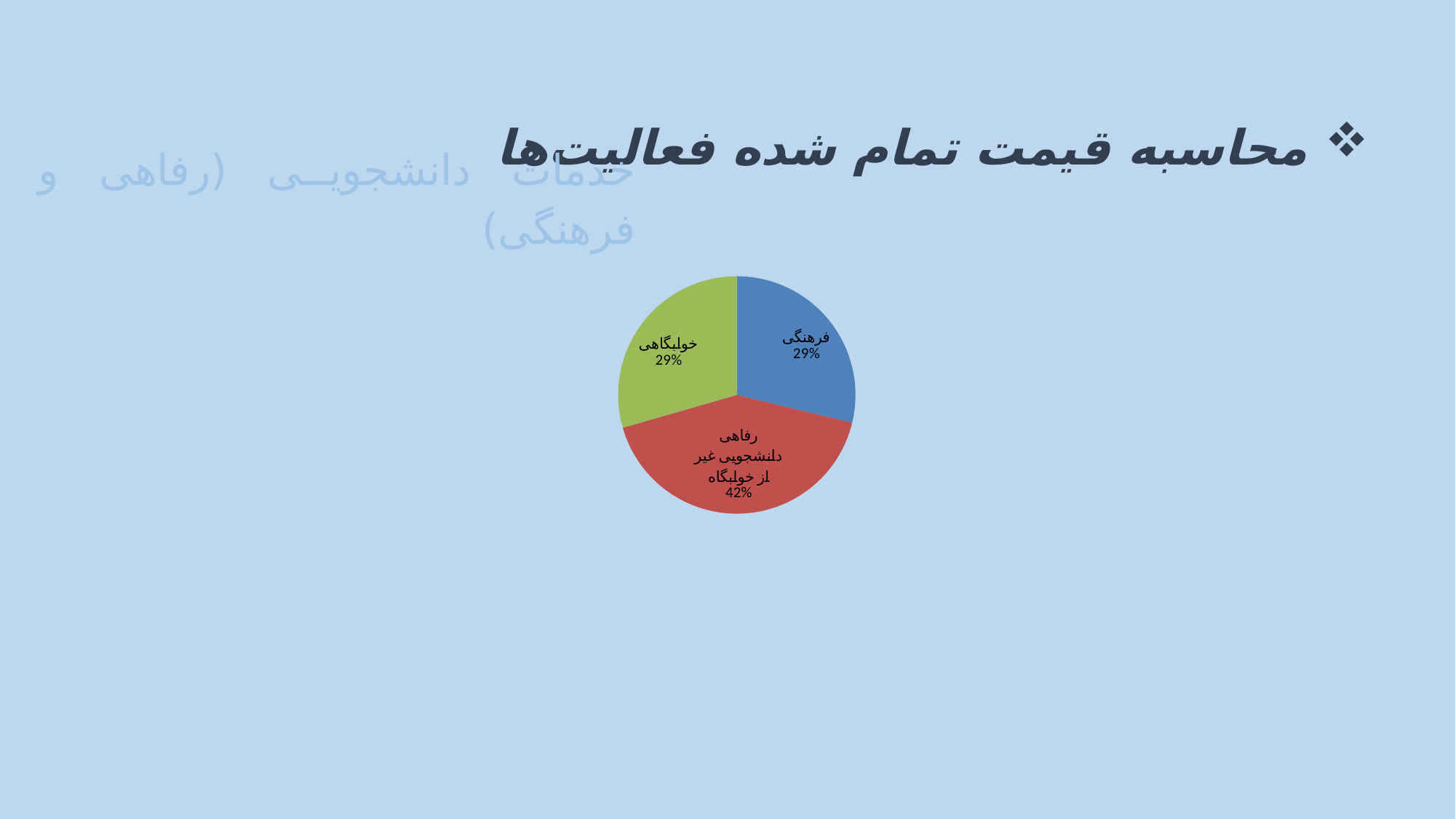
What colour is the slice labelled 42% in the pie chart? red What colour is the فرهنگی slice in the pie chart? blue Which slice of the pie chart is the largest? رفاهی دانشجویی غیر از خوابگاه What share of the pie does the فرهنگی slice represent? 29% What share of the pie does the خوابگاهی slice represent? 29% What is the difference in percentage points between the رفاهی دانشجویی غیر از خوابگاه slice and the خوابگاهی slice? 13 What share of the pie does the رفاهی دانشجویی غیر از خوابگاه slice represent? 42% What kind of chart is shown on the slide? pie chart Which is larger, the رفاهی دانشجویی غیر از خوابگاه slice or the فرهنگی slice? رفاهی دانشجویی غیر از خوابگاه What is the difference in percentage points between the فرهنگی slice and the خوابگاهی slice? 0 How many slices does the pie chart have? 3